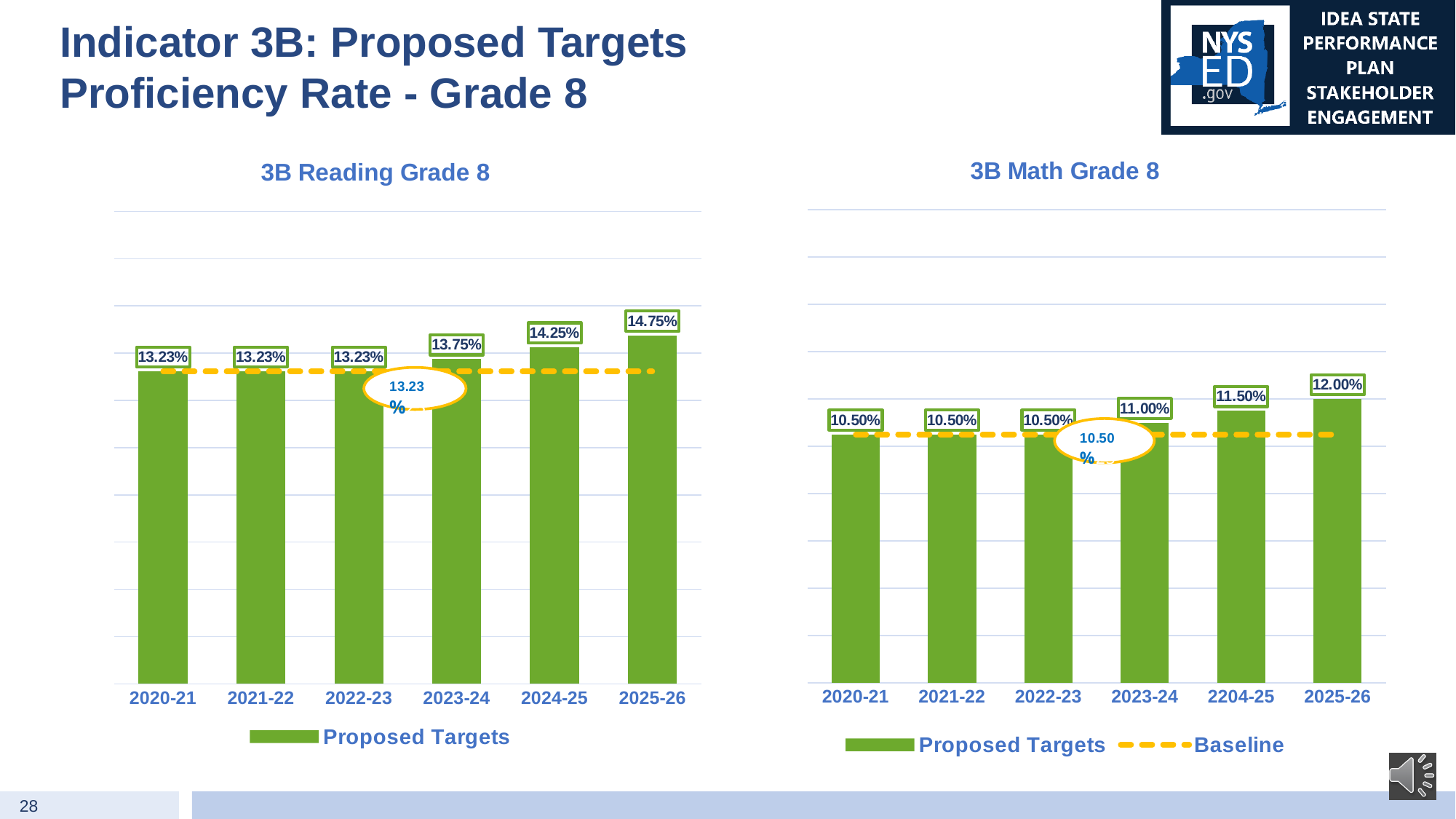
What baseline value is shown in the callout on the 3B Math Grade 8 chart? 10.50% In the 3B Math Grade 8 chart, what is the proposed target for 2023-24? 11.00% In the 3B Reading Grade 8 chart, what is the difference between the proposed targets for 2025-26 and 2023-24? 1.00% In the 3B Math Grade 8 chart, what is the difference between the proposed targets for 2025-26 and 2020-21? 1.50% In the 3B Math Grade 8 chart, which year has the highest proposed target? 2025-26 How many years are shown on the x axis of the 3B Math Grade 8 chart? 6 In the 3B Reading Grade 8 chart, what is the proposed target for 2025-26? 14.75% In the 3B Reading Grade 8 chart, is the proposed target for 2024-25 larger or smaller than the target for 2023-24? larger In the 3B Reading Grade 8 chart, what is the proposed target for 2020-21? 13.23% What kind of chart is the 3B Reading Grade 8 chart? bar chart How many entries does the legend of the 3B Math Grade 8 chart list? 2 In the 3B Reading Grade 8 chart, do the proposed targets rise or fall from 2022-23 to 2025-26? rise